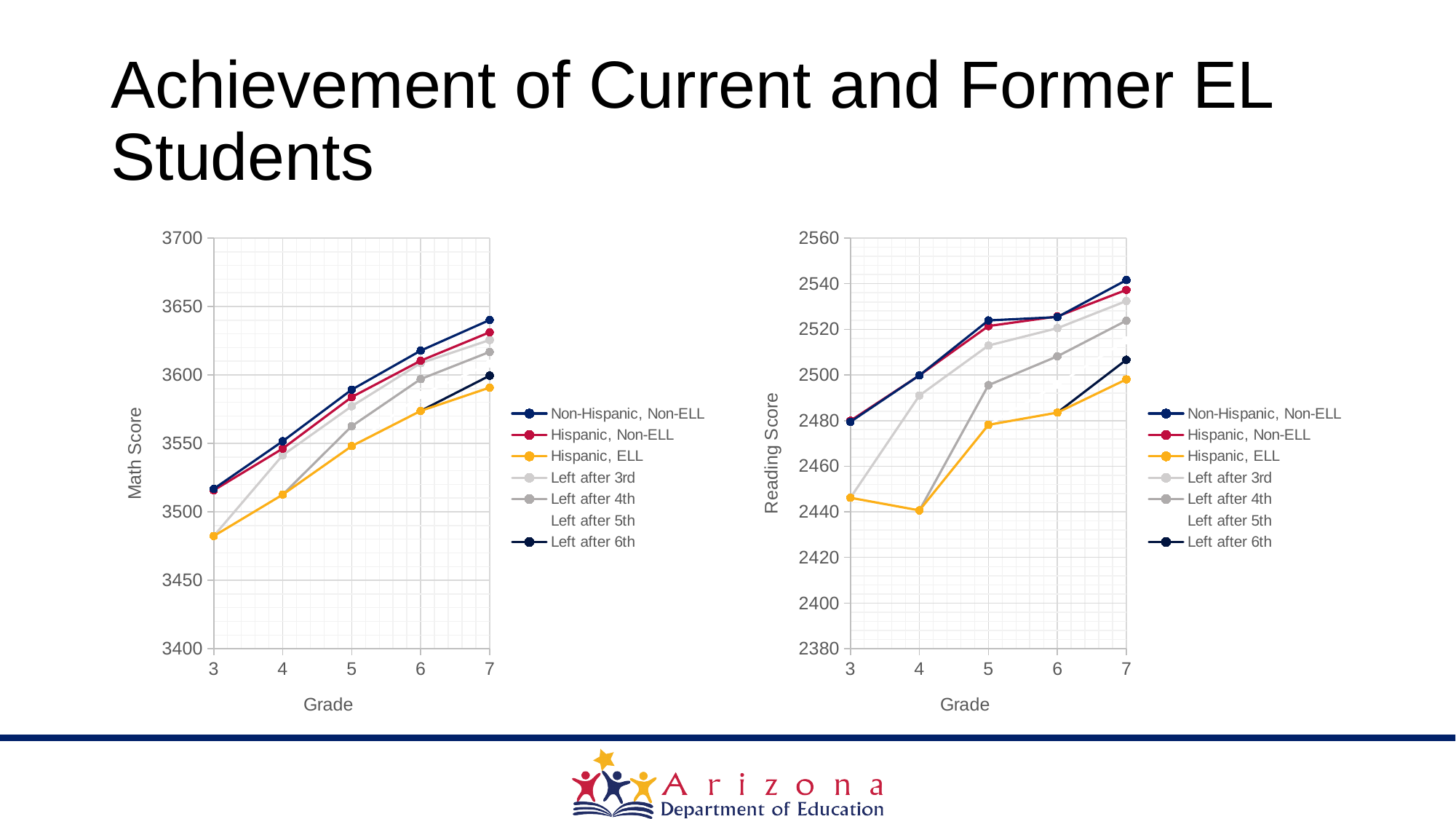
In the Math Score chart, does the Non-Hispanic, Non-ELL series rise or fall from grade 3 to grade 7? rise In the Math Score chart, which is larger at grade 5: Non-Hispanic, Non-ELL or Hispanic, ELL? Non-Hispanic, Non-ELL In the Reading Score chart, is the value for Non-Hispanic, Non-ELL at grade 7 greater or less than 2520? greater How many grades are plotted along the x axis of the Math Score chart? 5 What is the x-axis title of the Reading Score chart? Grade In the Reading Score chart, is the value for Hispanic, ELL at grade 4 greater or less than 2460? less How many series does the legend of the Reading Score chart list? 7 What kind of chart is the Math Score chart on the left? line chart In the Reading Score chart, which is larger at grade 7: Left after 4th or Hispanic, ELL? Left after 4th In the Math Score chart, which series has the highest value at grade 7? Non-Hispanic, Non-ELL In the Math Score chart, is the value for Non-Hispanic, Non-ELL at grade 7 greater or less than 3600? greater